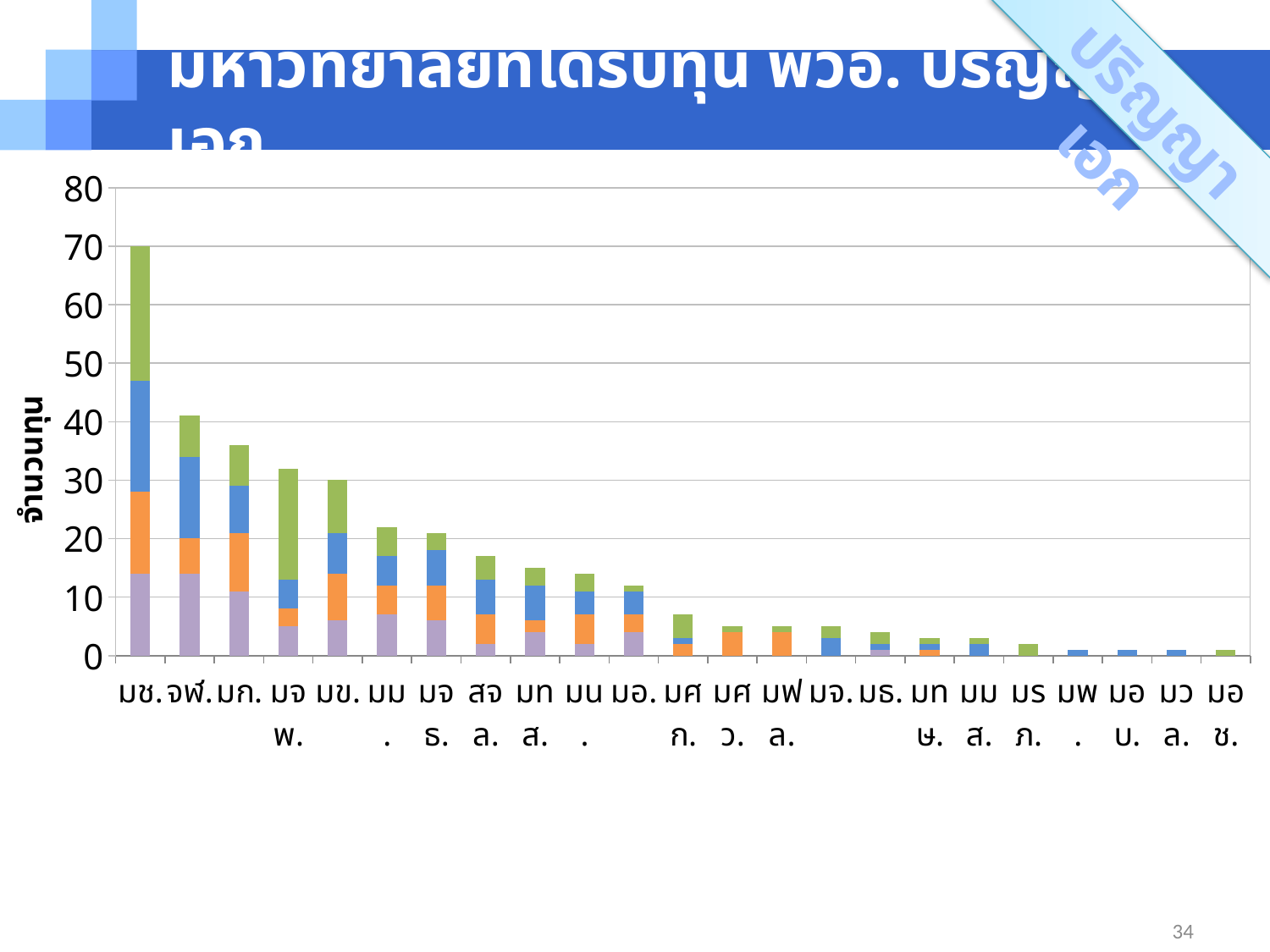
Is the total for มก. greater or less than 40? less Which bar is taller, จฬ. or มจพ.? จฬ. Which category has the tallest bar? มช. What is the label on the y axis? จำนวนทุน Is the total for มศก. greater or less than 10? less Which bar is taller, สจล. or มอ.? สจล. What is the total height of the bar for มช.? 70 Is the total for มม. greater or less than 20? greater What kind of chart is shown on the slide? stacked bar chart Do the bar totals generally rise or fall from left to right along the x axis? fall How many categories are shown on the x axis? 23